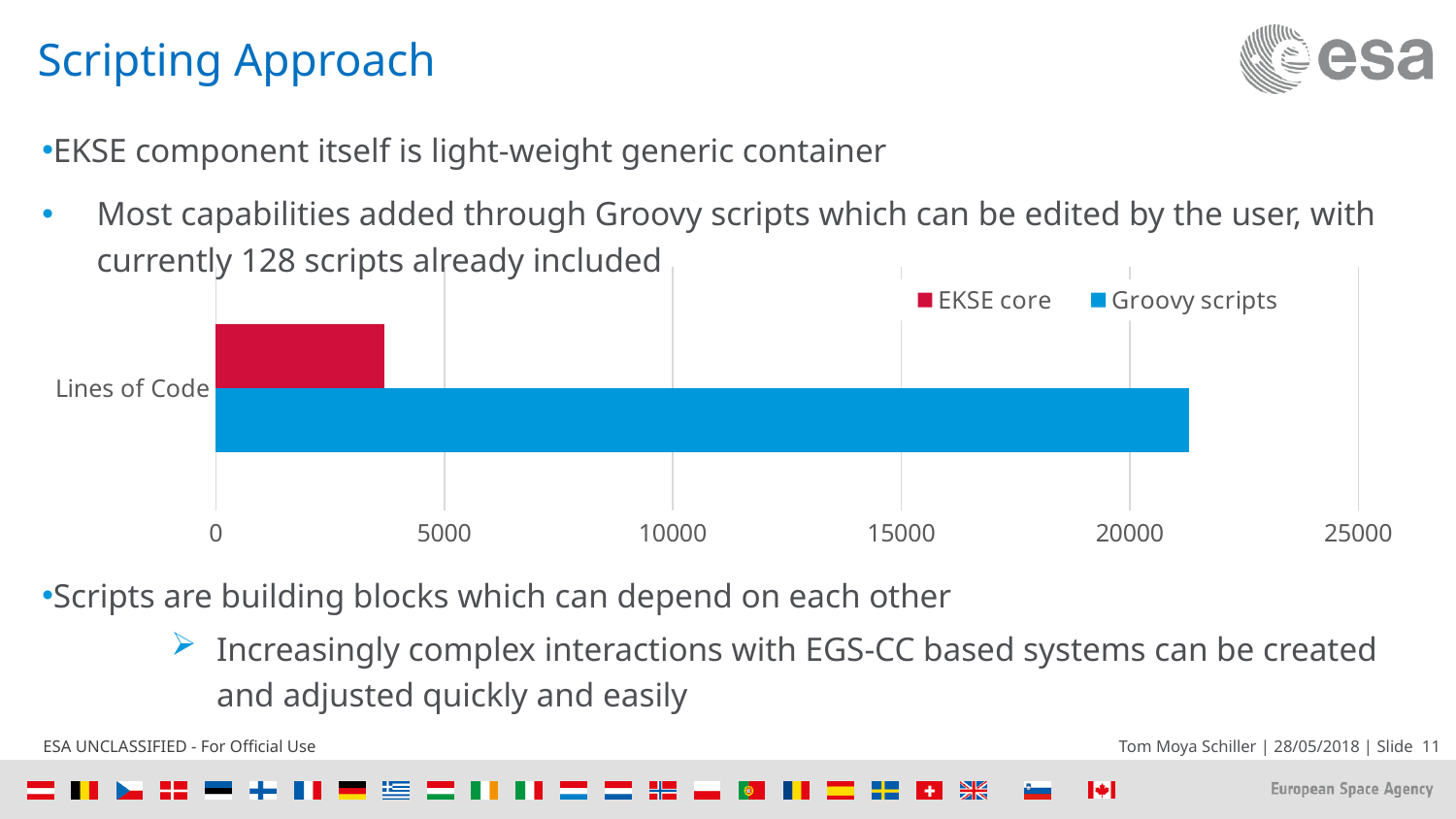
Is the value for EKSE core greater or less than 5000? less Is the value for Groovy scripts greater or less than 25000? less How many series does the chart legend list? 2 Which series has the larger value for Lines of Code, EKSE core or Groovy scripts? Groovy scripts What is the name of the category plotted on the chart? Lines of Code How many categories are plotted on the chart's vertical axis? 1 What is the highest value shown on the chart's horizontal axis? 25000 Is the value for EKSE core greater or less than 10000? less What kind of chart is shown on the slide? bar chart Which series has the smallest value for Lines of Code? EKSE core What colour represents the Groovy scripts series in the chart? blue